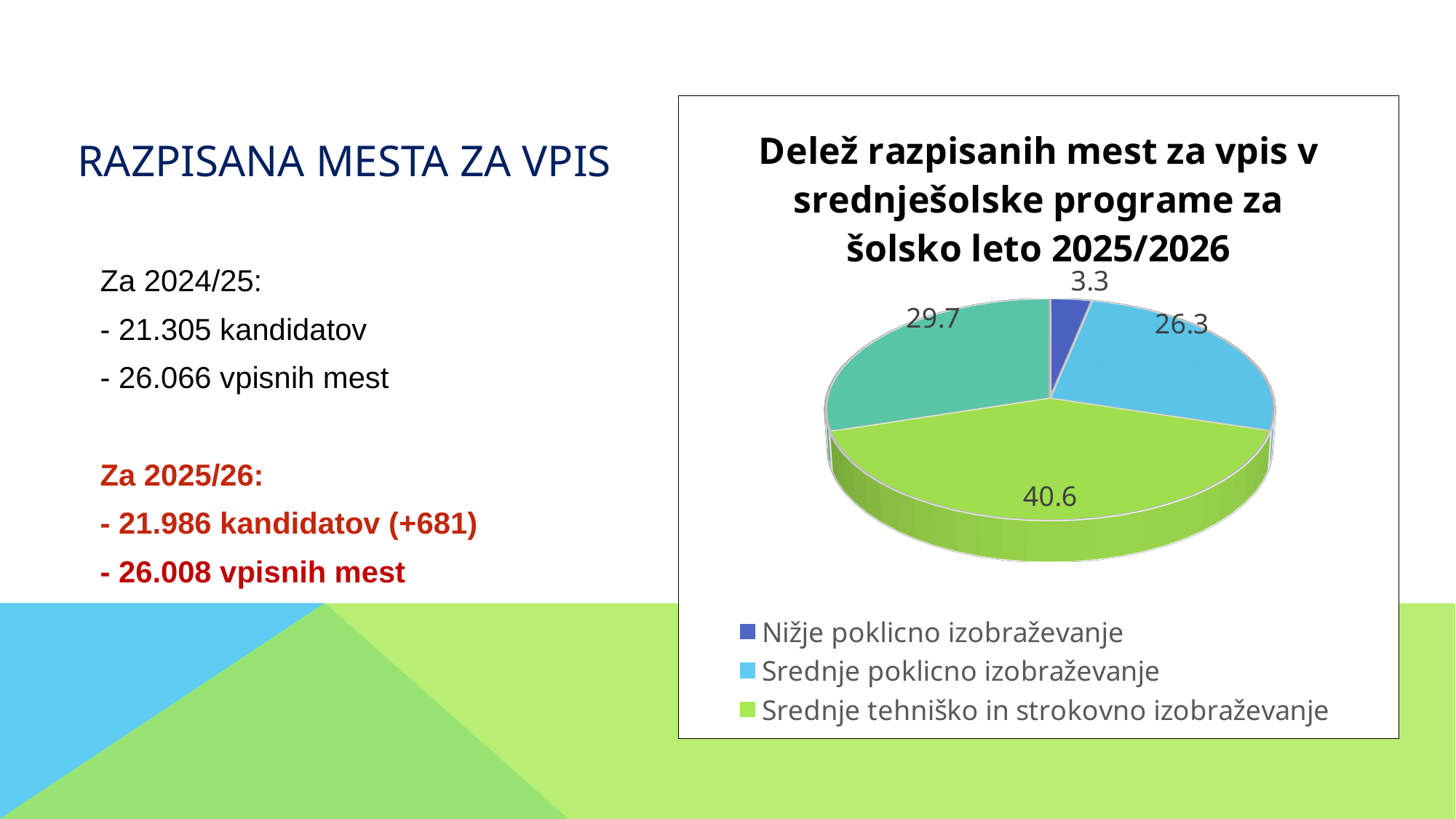
Which category has the smallest slice of the pie? Nižje poklicno izobraževanje Which is larger, the value for Srednje poklicno izobraževanje or the value for Nižje poklicno izobraževanje? Srednje poklicno izobraževanje How many slices does the pie chart have? 4 What type of chart is shown on the slide? pie chart How many entries does the legend list? 3 What is the value shown for Srednje tehniško in strokovno izobraževanje? 40.6 What is the title of the chart? Delež razpisanih mest za vpis v srednješolske programe za šolsko leto 2025/2026 What is the value shown for Srednje poklicno izobraževanje? 26.3 What is the difference between the values for Srednje tehniško in strokovno izobraževanje and Srednje poklicno izobraževanje? 14.3 Which category has the largest slice of the pie? Srednje tehniško in strokovno izobraževanje What is the value shown for Nižje poklicno izobraževanje? 3.3 What is the difference between the values for Srednje poklicno izobraževanje and Nižje poklicno izobraževanje? 23.0